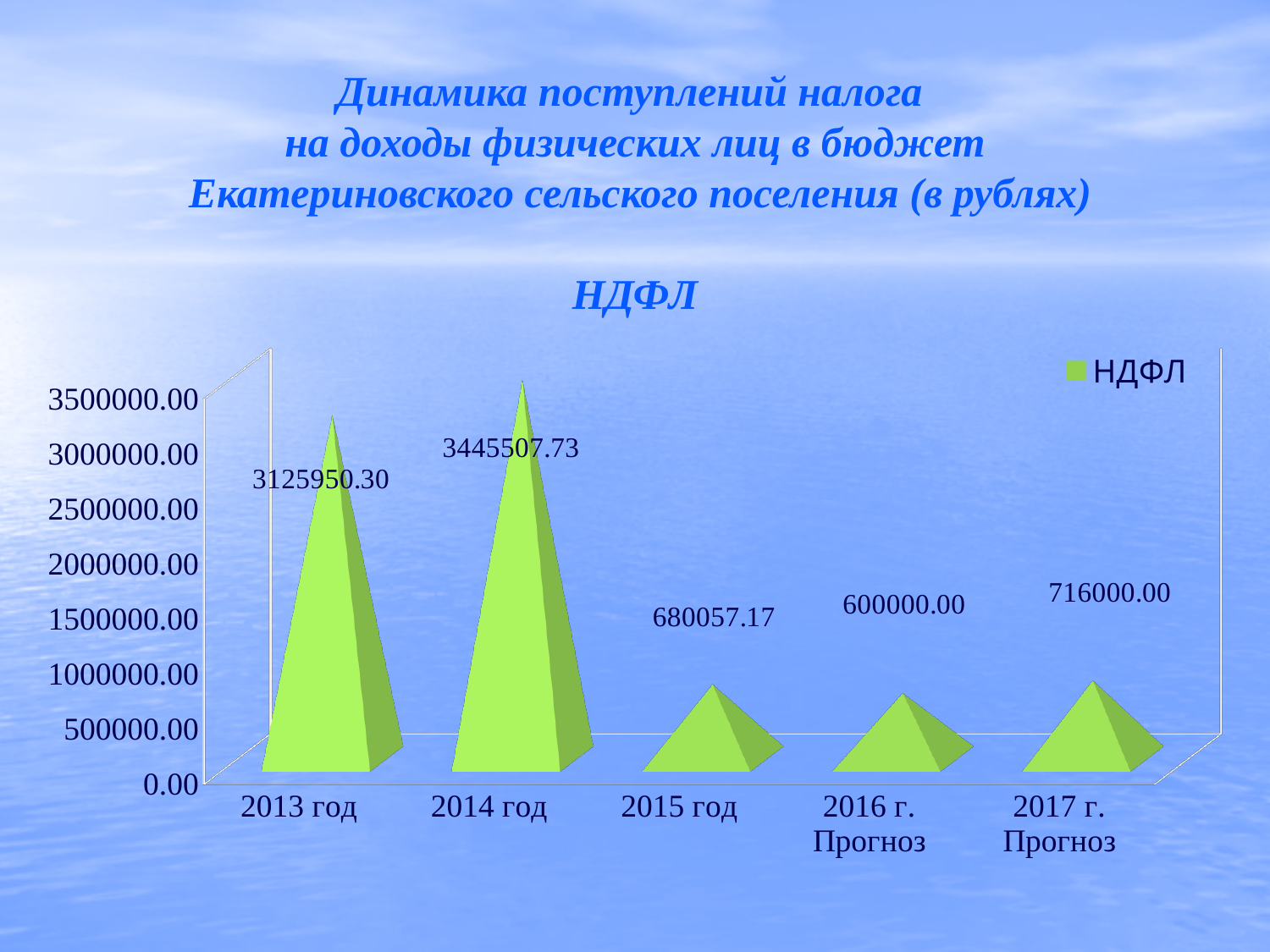
What is the value for 2015 год? 680057.17 How many categories are shown on the x axis? 5 Does the value rise or fall from 2014 год to 2015 год? fall Which category has the highest value? 2014 год What is the difference between the values for 2017 г. Прогноз and 2016 г. Прогноз? 116000.00 What is the value for 2016 г. Прогноз? 600000.00 What is the value for 2013 год? 3125950.30 What is the difference between the values for 2014 год and 2013 год? 319557.43 Which category has the lowest value? 2016 г. Прогноз Which is larger, the value for 2015 год or the value for 2017 г. Прогноз? 2017 г. Прогноз How many series does the legend list? 1 What is the value for 2014 год? 3445507.73